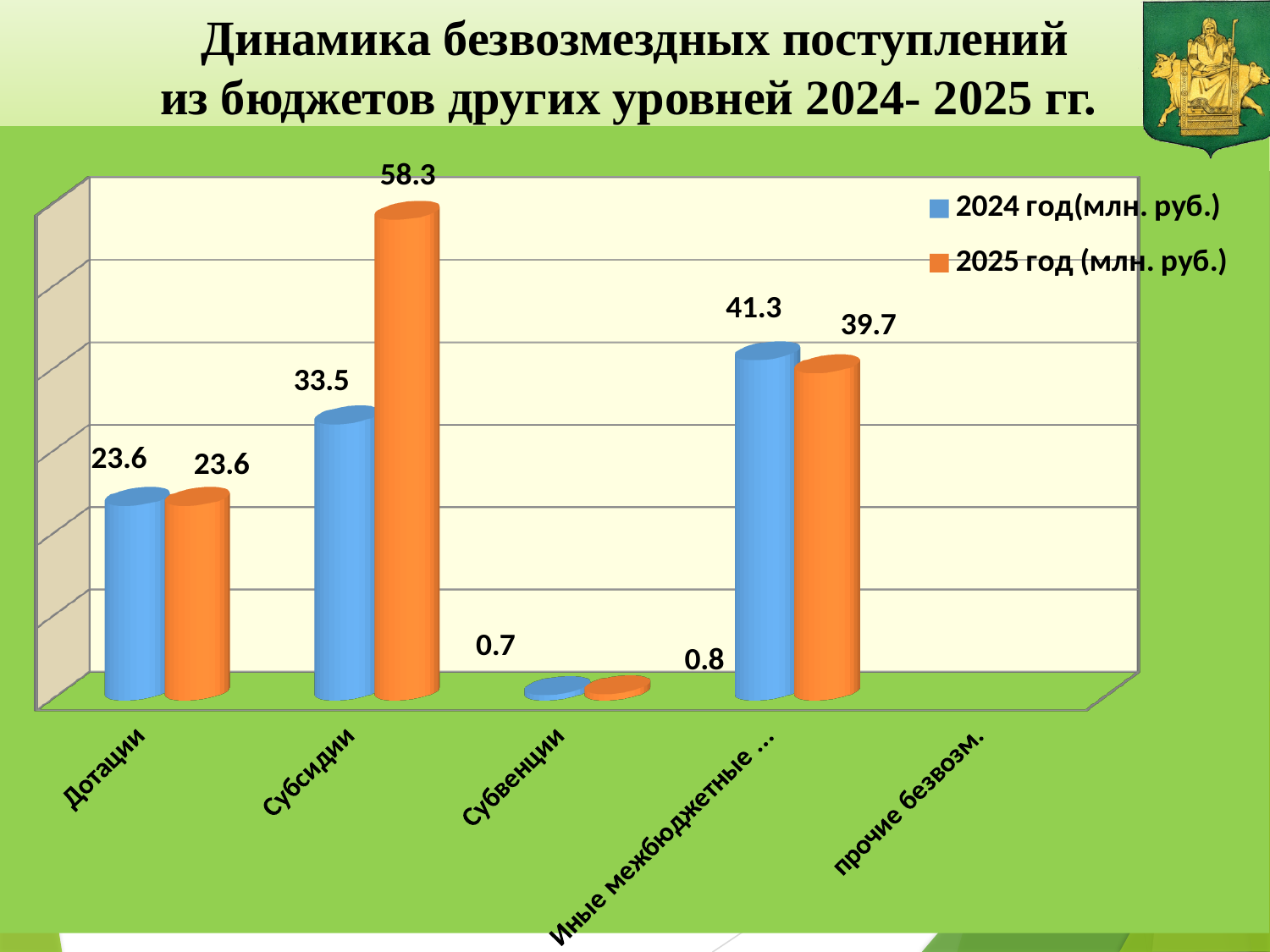
Which category has the highest value in the 2025 год (млн. руб.) series? Субсидии What is the difference between the 2025 and 2024 values for Субсидии? 24.8 Which category has the lowest value in the 2024 год (млн. руб.) series among those with labelled bars? Субвенции How many series does the legend list? 2 For Иные межбюджетные ..., which year has the larger value, 2024 or 2025? 2024 What is the value for Субсидии in the 2024 год (млн. руб.) series? 33.5 What is the 2025 год (млн. руб.) value for Субвенции? 0.8 What kind of chart is shown on the slide? Bar chart What is the 2024 год (млн. руб.) value for Иные межбюджетные ...? 41.3 What is the 2024 год (млн. руб.) value for Дотации? 23.6 How many categories are shown on the x axis? 5 What is the value for Субсидии in the 2025 год (млн. руб.) series? 58.3